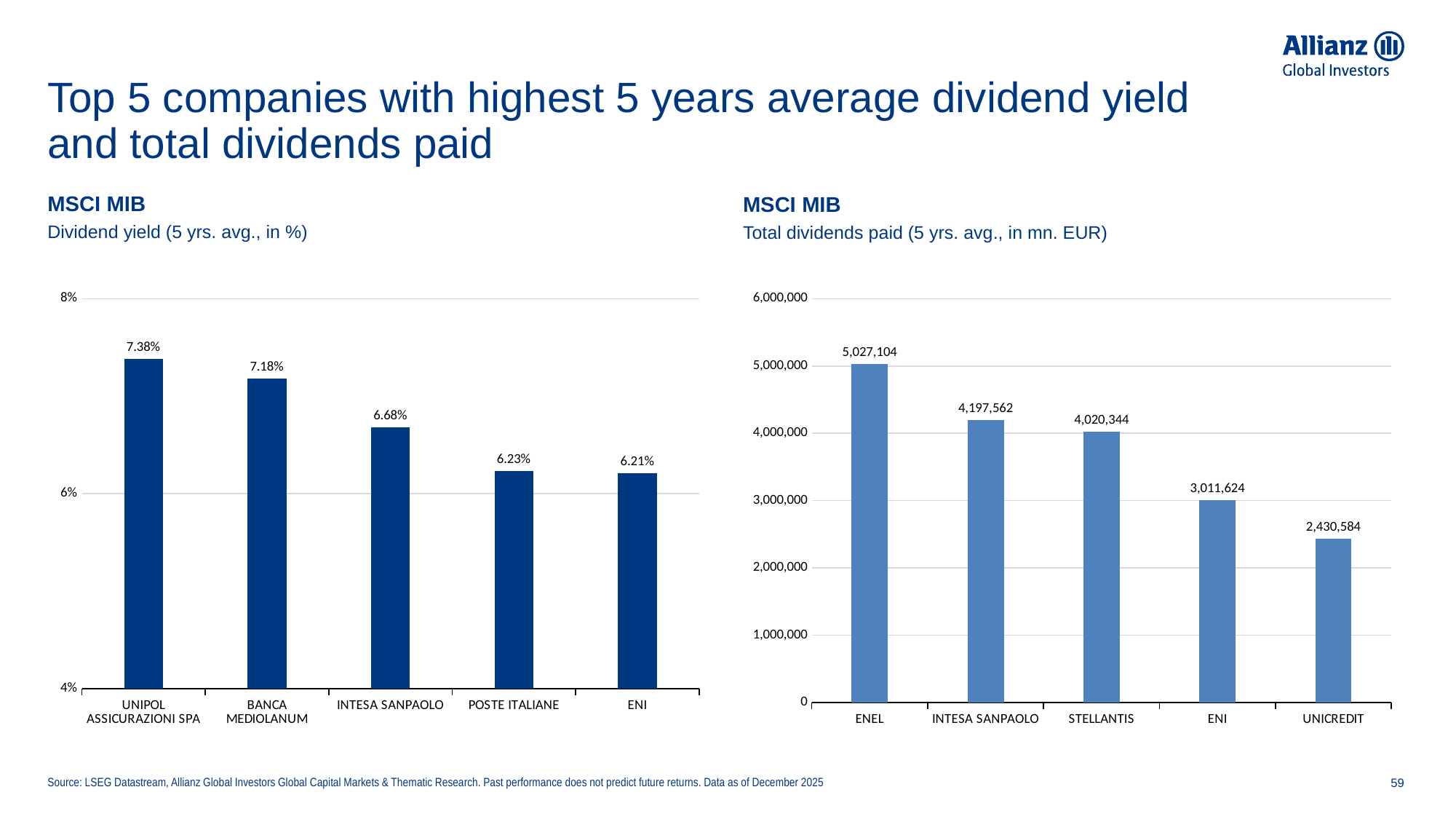
In the Total dividends paid chart, is the value for INTESA SANPAOLO greater or less than 4,000,000? greater In the Total dividends paid chart, which company has the highest value? ENEL In the Dividend yield chart, how many companies are shown? 5 In the Total dividends paid chart, which is larger: the value for STELLANTIS or the value for ENI? STELLANTIS In the Dividend yield chart, what is the value for INTESA SANPAOLO? 6.68% In the Dividend yield chart, what is the difference between BANCA MEDIOLANUM and POSTE ITALIANE? 0.95% What kind of chart is the Total dividends paid chart? Bar chart In the Total dividends paid chart, what is the value for STELLANTIS? 4,020,344 In the Total dividends paid chart, what is the difference between ENEL and ENI? 2,015,480 In the Dividend yield chart, what is the value for UNIPOL ASSICURAZIONI SPA? 7.38% In the Total dividends paid chart, what is the value for UNICREDIT? 2,430,584 In the Dividend yield chart, which company has the lowest dividend yield? ENI